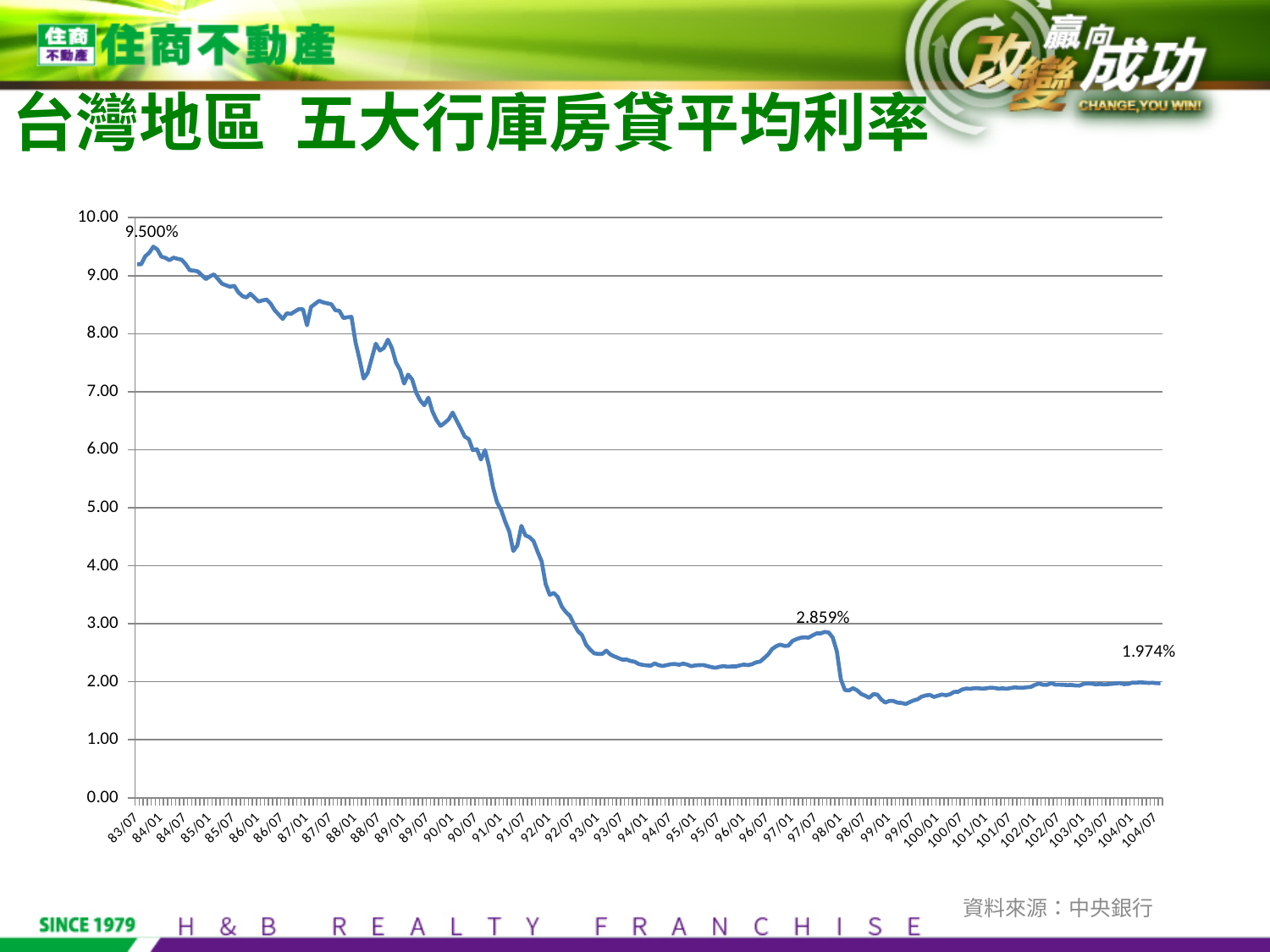
Overall, does the mortgage rate rise or fall from 83/07 to 104/07? fall What is the title of the chart on the slide? 台灣地區 五大行庫房貸平均利率 What is the highest value labelled on the line? 9.500% What is the difference between the labelled values 2.859% and 1.974%? 0.885 percentage points What kind of chart is shown on the slide? line chart What is the difference between the labelled peak value 9.500% and the final labelled value 1.974%? 7.526 percentage points Which is larger, the labelled value around 97/07 or the labelled value at 104/07? the value around 97/07 (2.859%) What value is labelled on the local peak around 97/07? 2.859% What is the data source cited for the chart? 中央銀行 Is the value at 99/01 greater or less than 2.00? less What value is labelled at the end of the line, at 104/07? 1.974% Is the value at 90/01 greater or less than 6.00? greater